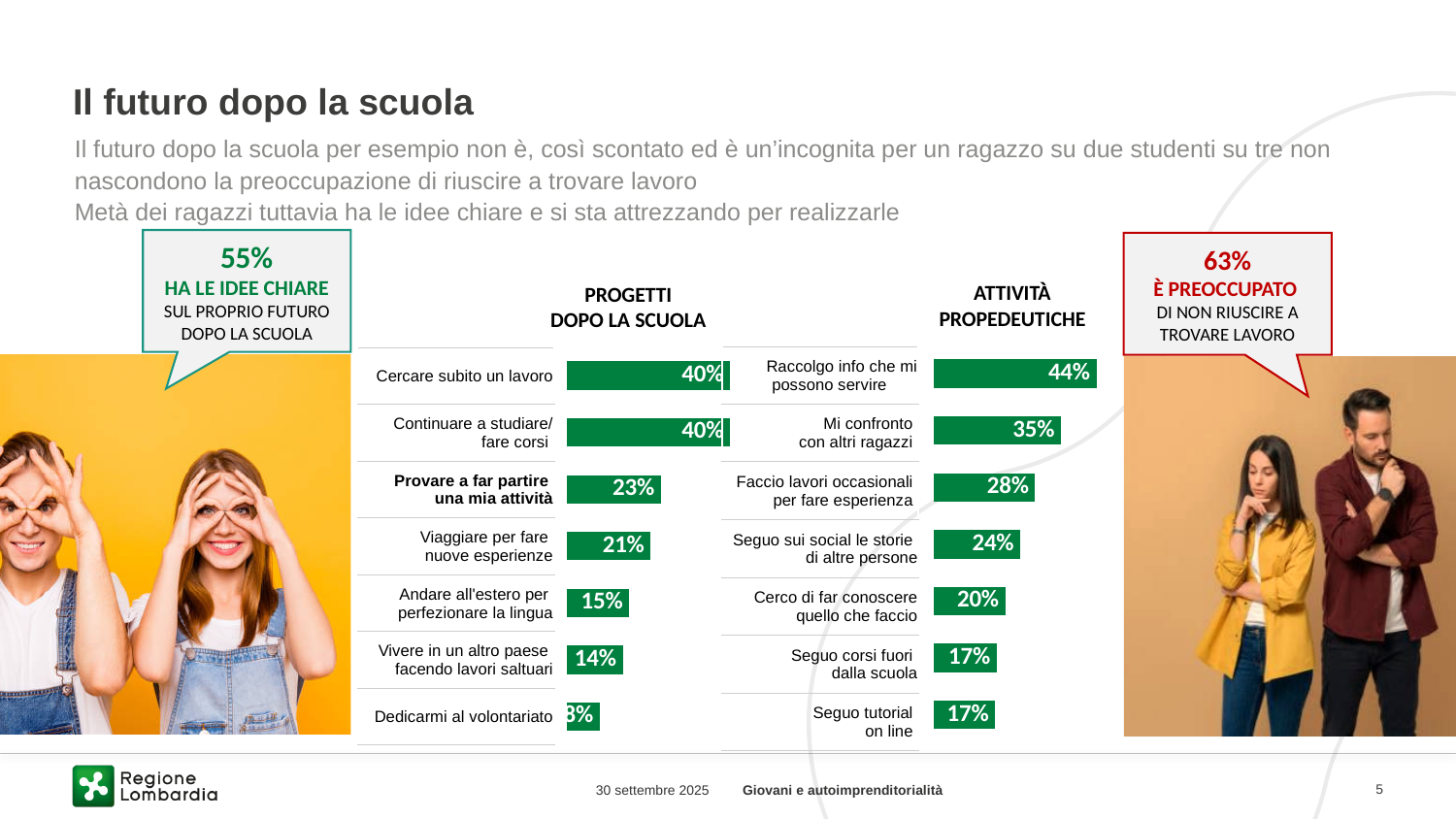
In the ATTIVITÀ PROPEDEUTICHE chart, what is the value for 'Seguo sui social le storie di altre persone'? 24% In the PROGETTI DOPO LA SCUOLA chart, what is the value for 'Cercare subito un lavoro'? 40% What type of chart is the PROGETTI DOPO LA SCUOLA chart? Bar chart In the PROGETTI DOPO LA SCUOLA chart, what is the value for 'Provare a far partire una mia attività'? 23% In the ATTIVITÀ PROPEDEUTICHE chart, what is the difference between 'Raccolgo info che mi possono servire' and 'Faccio lavori occasionali per fare esperienza'? 16% How many categories are shown in the ATTIVITÀ PROPEDEUTICHE chart? 7 In the ATTIVITÀ PROPEDEUTICHE chart, what is the value for 'Mi confronto con altri ragazzi'? 35% In the ATTIVITÀ PROPEDEUTICHE chart, which category has the highest value? Raccolgo info che mi possono servire In the PROGETTI DOPO LA SCUOLA chart, what is the difference between 'Viaggiare per fare nuove esperienze' and 'Andare all'estero per perfezionare la lingua'? 6% In the PROGETTI DOPO LA SCUOLA chart, which category has the lowest value? Dedicarmi al volontariato In the PROGETTI DOPO LA SCUOLA chart, which is larger: 'Andare all'estero per perfezionare la lingua' or 'Vivere in un altro paese facendo lavori saltuari'? Andare all'estero per perfezionare la lingua In the ATTIVITÀ PROPEDEUTICHE chart, what value is shown for both 'Seguo corsi fuori dalla scuola' and 'Seguo tutorial on line'? 17%